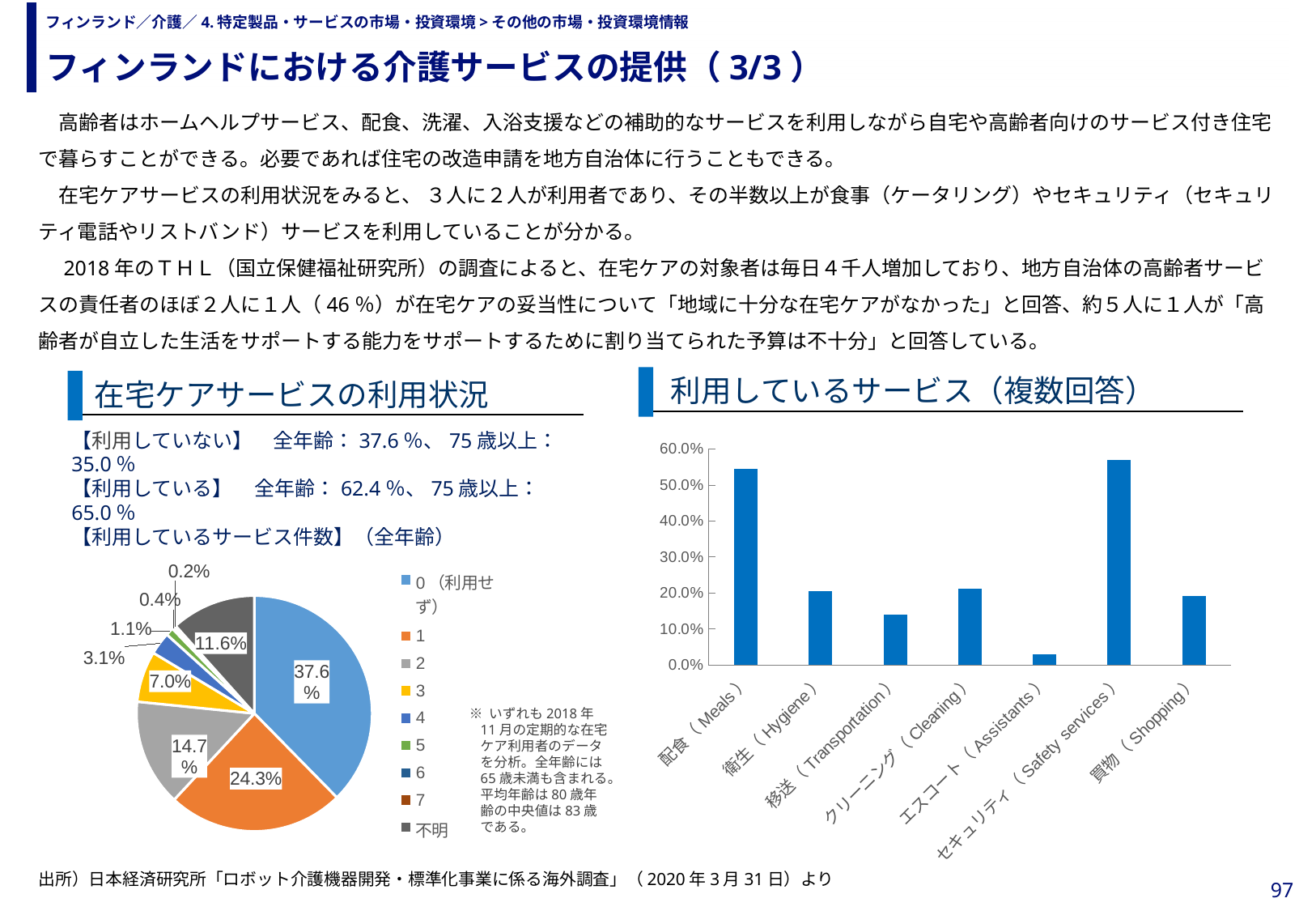
What type of chart is the chart on the right titled 利用しているサービス（複数回答）? bar chart In the bar chart 利用しているサービス（複数回答）, which category has the lowest value? エスコート（Assistants） How many categories are shown in the bar chart 利用しているサービス（複数回答）? 7 In the pie chart on the left, what percentage is shown for 不明? 11.6% In the pie chart on the left, which category has the largest slice? 0（利用せず） In the bar chart 利用しているサービス（複数回答）, is the value for 配食（Meals） greater or less than 50.0%? greater How many entries does the legend of the pie chart on the left list? 9 In the bar chart 利用しているサービス（複数回答）, is the value for 移送（Transportation） greater or less than 20.0%? less In the pie chart on the left, what percentage is shown for the category 1? 24.3% In the pie chart on the left, what is the difference between the slice for 0（利用せず） and the slice for 1? 13.3% What type of chart is the chart on the left under 在宅ケアサービスの利用状況? pie chart In the bar chart 利用しているサービス（複数回答）, which is larger: 配食（Meals） or 衛生（Hygiene）? 配食（Meals）